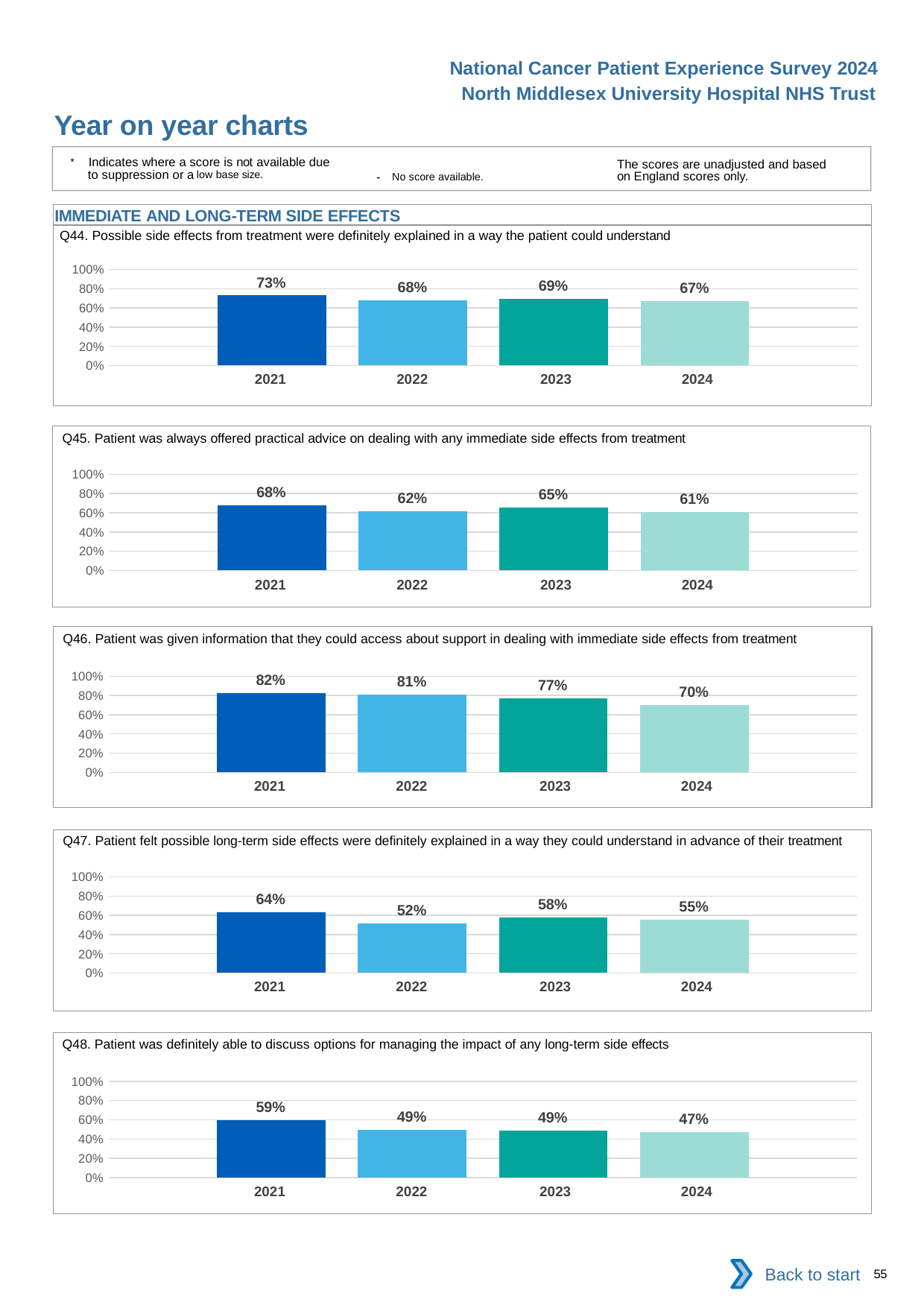
In the Q46 chart, do the values rise or fall from 2021 to 2024? Fall In the Q46 chart, is the value for 2023 greater or less than 60%? greater How many years are shown in the Q44 chart? 4 In the Q47 chart, which year has the highest value? 2021 In the Q48 chart, what is the value for 2024? 47% In the Q47 chart, is the value for 2022 larger or smaller than the value for 2023? smaller In the Q45 chart, which year has the lowest value? 2024 How many charts are shown on the slide? 5 What kind of chart is the Q45 chart? Bar chart In the Q45 chart, what is the difference between the 2021 and 2022 values? 6 percentage points In the Q46 chart, what is the difference between the 2021 and 2024 values? 12 percentage points In the Q44 chart, what is the value for 2021? 73%